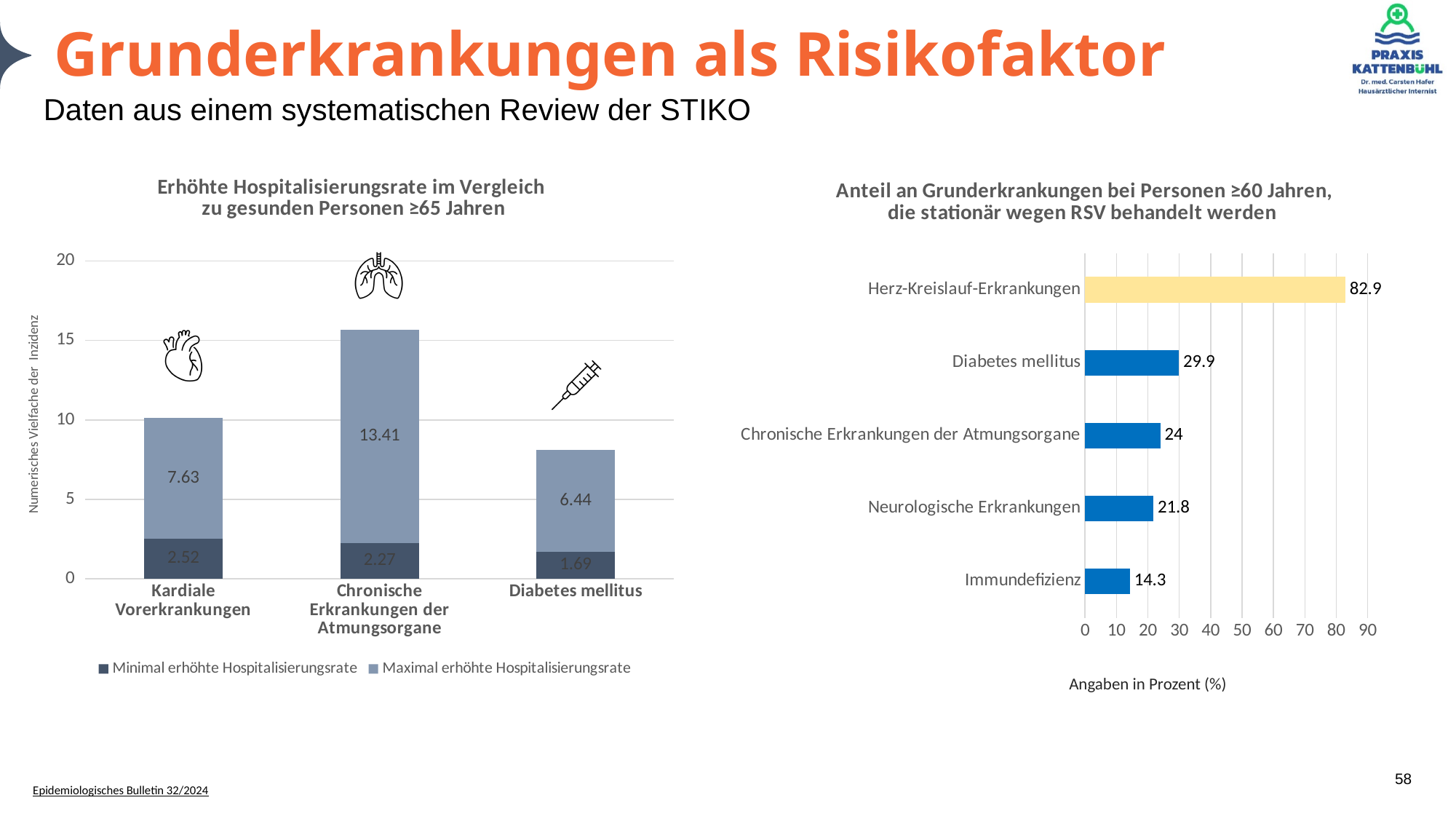
In the right chart 'Anteil an Grunderkrankungen bei Personen ≥60 Jahren, die stationär wegen RSV behandelt werden', which category has the lowest value? Immundefizienz In the right chart 'Anteil an Grunderkrankungen bei Personen ≥60 Jahren, die stationär wegen RSV behandelt werden', what is the value for Herz-Kreislauf-Erkrankungen? 82.9 In the left chart 'Erhöhte Hospitalisierungsrate im Vergleich zu gesunden Personen ≥65 Jahren', which category has the highest 'Maximal erhöhte Hospitalisierungsrate'? Chronische Erkrankungen der Atmungsorgane In the left chart 'Erhöhte Hospitalisierungsrate im Vergleich zu gesunden Personen ≥65 Jahren', how many series does the legend list? 2 In the left chart 'Erhöhte Hospitalisierungsrate im Vergleich zu gesunden Personen ≥65 Jahren', what is the difference between the 'Maximal erhöhte Hospitalisierungsrate' for Kardiale Vorerkrankungen and for Diabetes mellitus? 1.19 In the right chart 'Anteil an Grunderkrankungen bei Personen ≥60 Jahren, die stationär wegen RSV behandelt werden', which is larger: Chronische Erkrankungen der Atmungsorgane or Immundefizienz? Chronische Erkrankungen der Atmungsorgane In the right chart 'Anteil an Grunderkrankungen bei Personen ≥60 Jahren, die stationär wegen RSV behandelt werden', how many categories are shown? 5 In the left chart 'Erhöhte Hospitalisierungsrate im Vergleich zu gesunden Personen ≥65 Jahren', what is the value of 'Maximal erhöhte Hospitalisierungsrate' for Chronische Erkrankungen der Atmungsorgane? 13.41 In the left chart 'Erhöhte Hospitalisierungsrate im Vergleich zu gesunden Personen ≥65 Jahren', what is the total of the stacked bar for Diabetes mellitus? 8.13 In the right chart 'Anteil an Grunderkrankungen bei Personen ≥60 Jahren, die stationär wegen RSV behandelt werden', what is the difference between Diabetes mellitus and Neurologische Erkrankungen? 8.1 What kind of chart is the right chart 'Anteil an Grunderkrankungen bei Personen ≥60 Jahren, die stationär wegen RSV behandelt werden'? Bar chart In the left chart 'Erhöhte Hospitalisierungsrate im Vergleich zu gesunden Personen ≥65 Jahren', what is the value of 'Minimal erhöhte Hospitalisierungsrate' for Kardiale Vorerkrankungen? 2.52